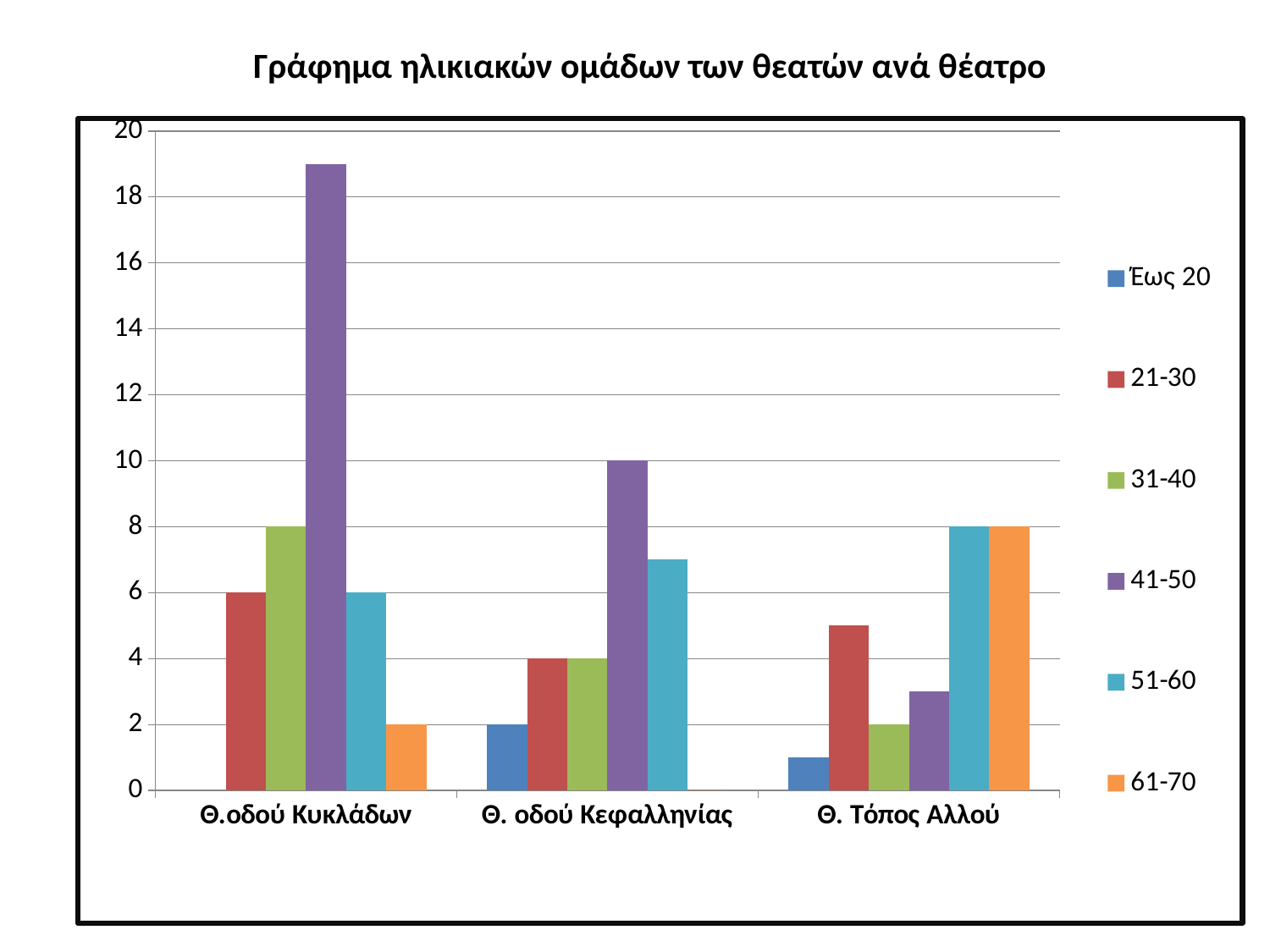
What is the value for the 61-70 age group at Θ.οδού Κυκλάδων? 2 What is the value for the 51-60 age group at Θ. Τόπος Αλλού? 8 What is the difference between the 31-40 and 21-30 values at Θ.οδού Κυκλάδων? 2 How many theatres (categories) are shown on the x axis? 3 What kind of chart is shown on the slide? bar chart Which is larger: the 41-50 value at Θ. οδού Κεφαλληνίας or the 31-40 value at Θ.οδού Κυκλάδων? 41-50 at Θ. οδού Κεφαλληνίας What is the value for the 41-50 age group at Θ. οδού Κεφαλληνίας? 10 Which age group has the highest bar at Θ.οδού Κυκλάδων? 41-50 Is the value for the 51-60 age group at Θ. οδού Κεφαλληνίας greater or less than 6? greater How many age-group series does the legend list? 6 What is the value for the 31-40 age group at Θ.οδού Κυκλάδων? 8 Is the value for the 41-50 age group at Θ.οδού Κυκλάδων greater or less than 18? greater